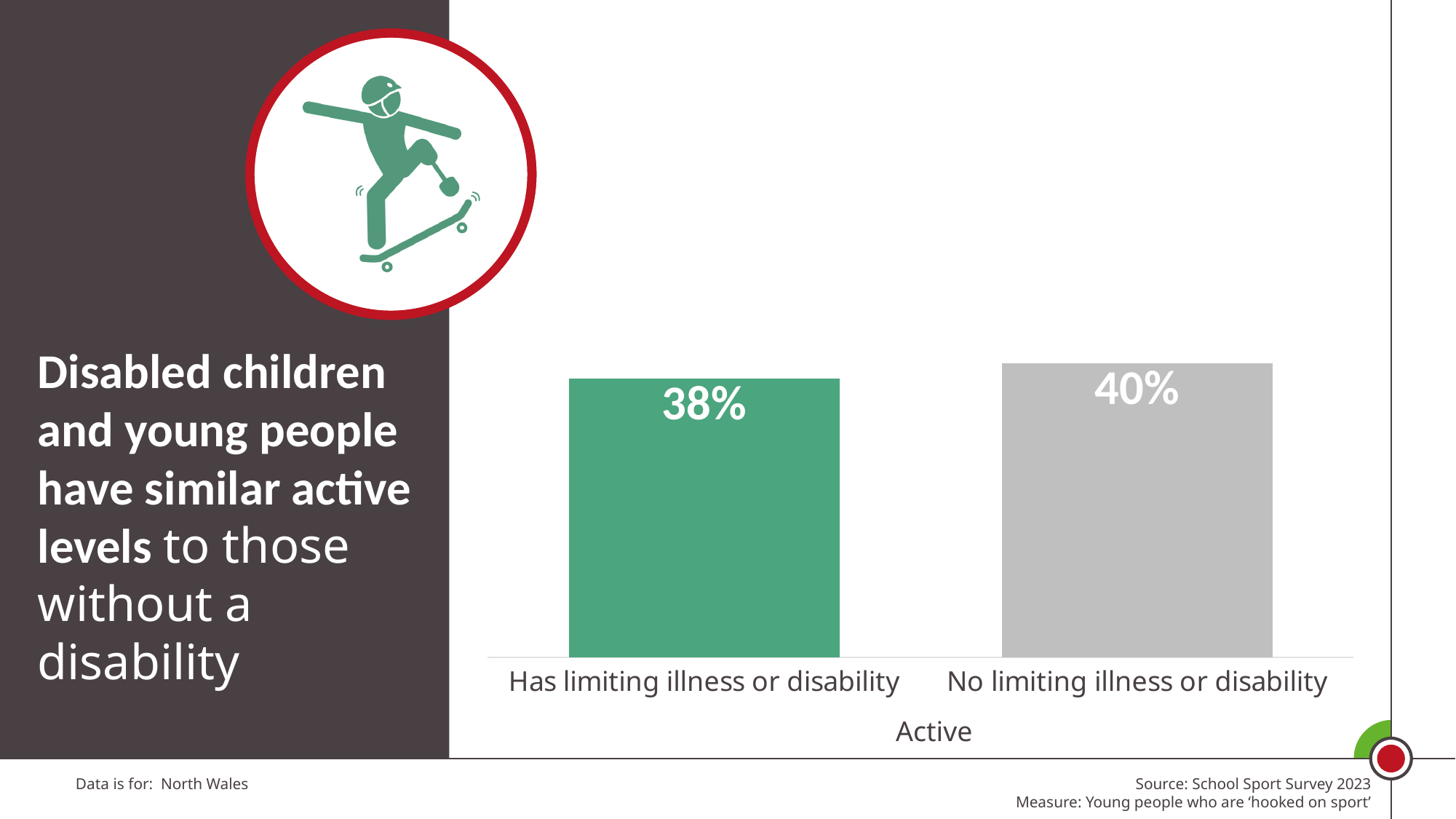
What is the value for 'Has limiting illness or disability'? 38% What is the difference between the values for 'No limiting illness or disability' and 'Has limiting illness or disability'? 2% What is the label shown beneath the category axis of the chart? Active Which category has the higher value? No limiting illness or disability Is the value for 'Has limiting illness or disability' larger or smaller than the value for 'No limiting illness or disability'? smaller What is the value for 'No limiting illness or disability'? 40% What kind of chart is shown on the slide? bar chart What colour is the bar for 'Has limiting illness or disability'? green Which category has the lower value? Has limiting illness or disability How many categories are shown in the chart? 2